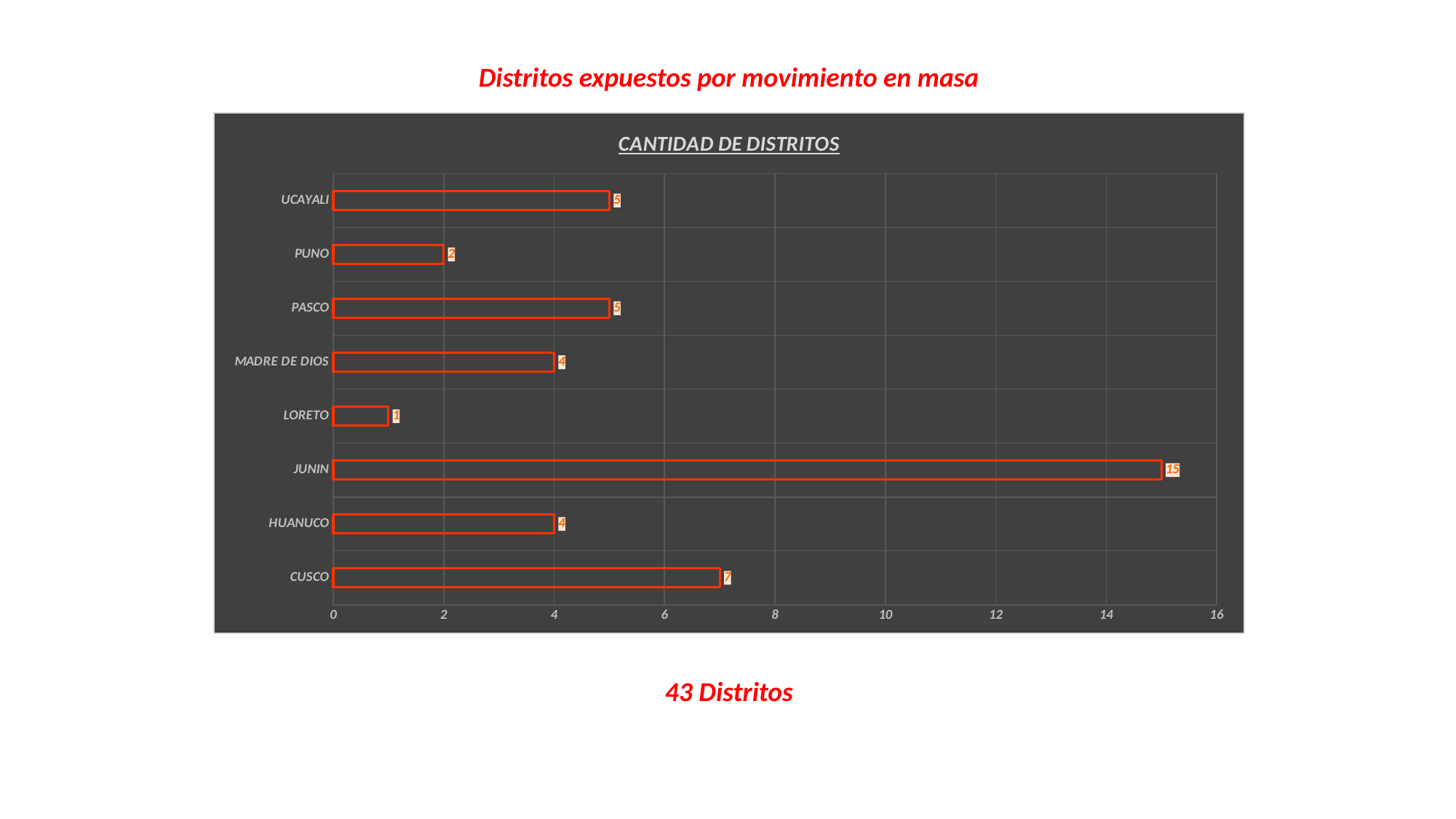
What is the value for MADRE DE DIOS? 4 What is the value for CUSCO? 7 Is the value for JUNIN greater or less than 10? greater What is the title of the chart? CANTIDAD DE DISTRITOS What kind of chart is shown? bar chart Which category has the highest value? JUNIN Which is larger, the value for PUNO or the value for PASCO? PASCO What is the value for JUNIN? 15 Which category has the lowest value? LORETO What is the difference between the values for JUNIN and CUSCO? 8 What is the value for LORETO? 1 How many categories are shown in the chart? 8